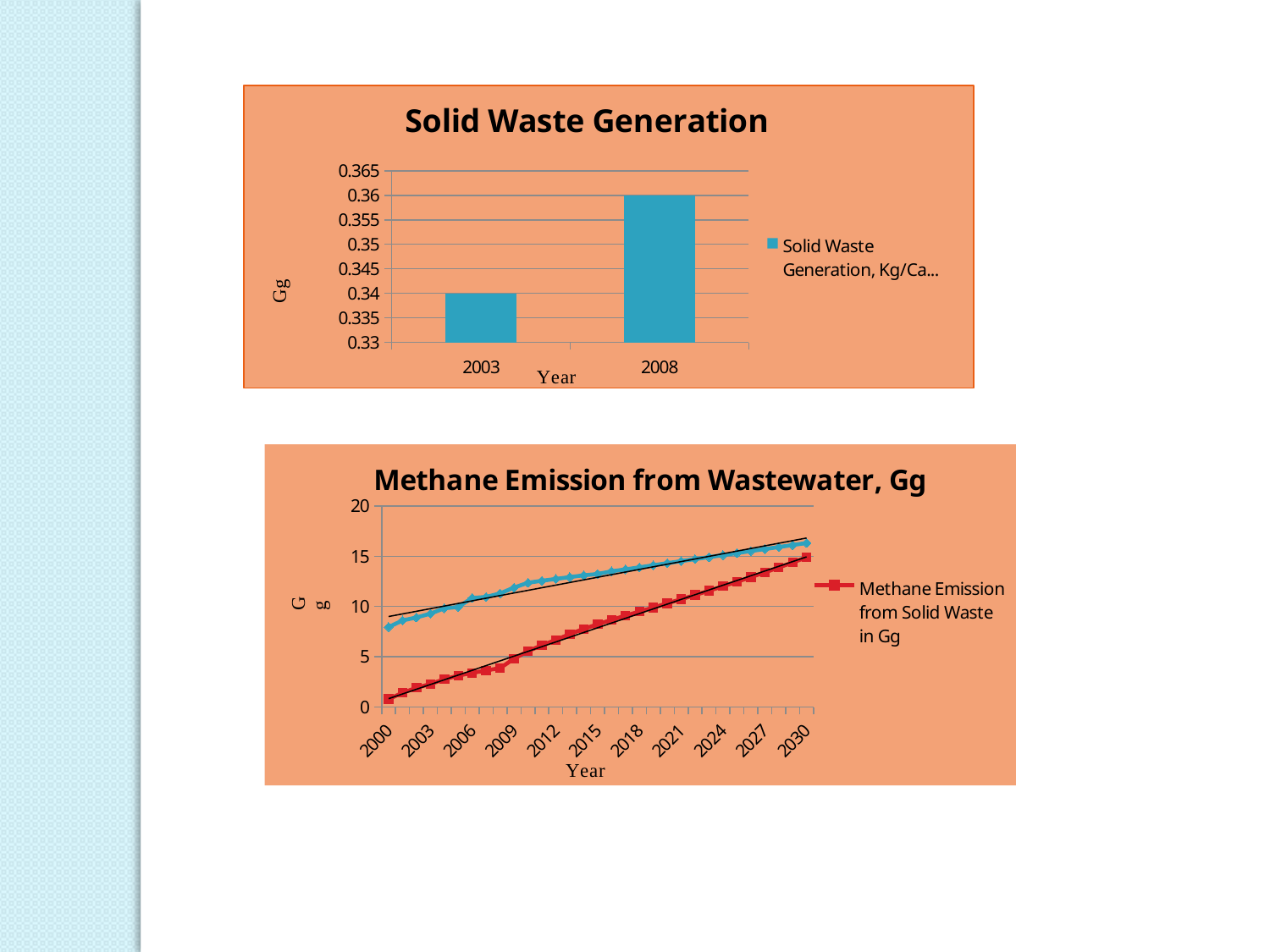
What kind of chart is the Solid Waste Generation chart? bar chart What kind of chart is the Methane Emission from Wastewater, Gg chart? line chart In the Methane Emission from Wastewater, Gg chart, do the values of the red series rise or fall from 2000 to 2030? rise In the Solid Waste Generation chart, how many years are shown on the x axis? 2 In the Methane Emission from Wastewater, Gg chart, is the value of the red series in 2000 greater or less than 5? less In the Solid Waste Generation chart, what is the value for 2008? 0.36 In the Methane Emission from Wastewater, Gg chart, which series has the higher value in 2000, the blue series or the red series? the blue series In the Solid Waste Generation chart, what is the label on the vertical axis? Gg In the Solid Waste Generation chart, what is the difference between the 2008 and 2003 values? 0.02 In the Solid Waste Generation chart, which year has the higher value? 2008 In the Solid Waste Generation chart, what is the value for 2003? 0.34 In the Methane Emission from Wastewater, Gg chart, is the value of the blue series in 2030 greater or less than 15? greater